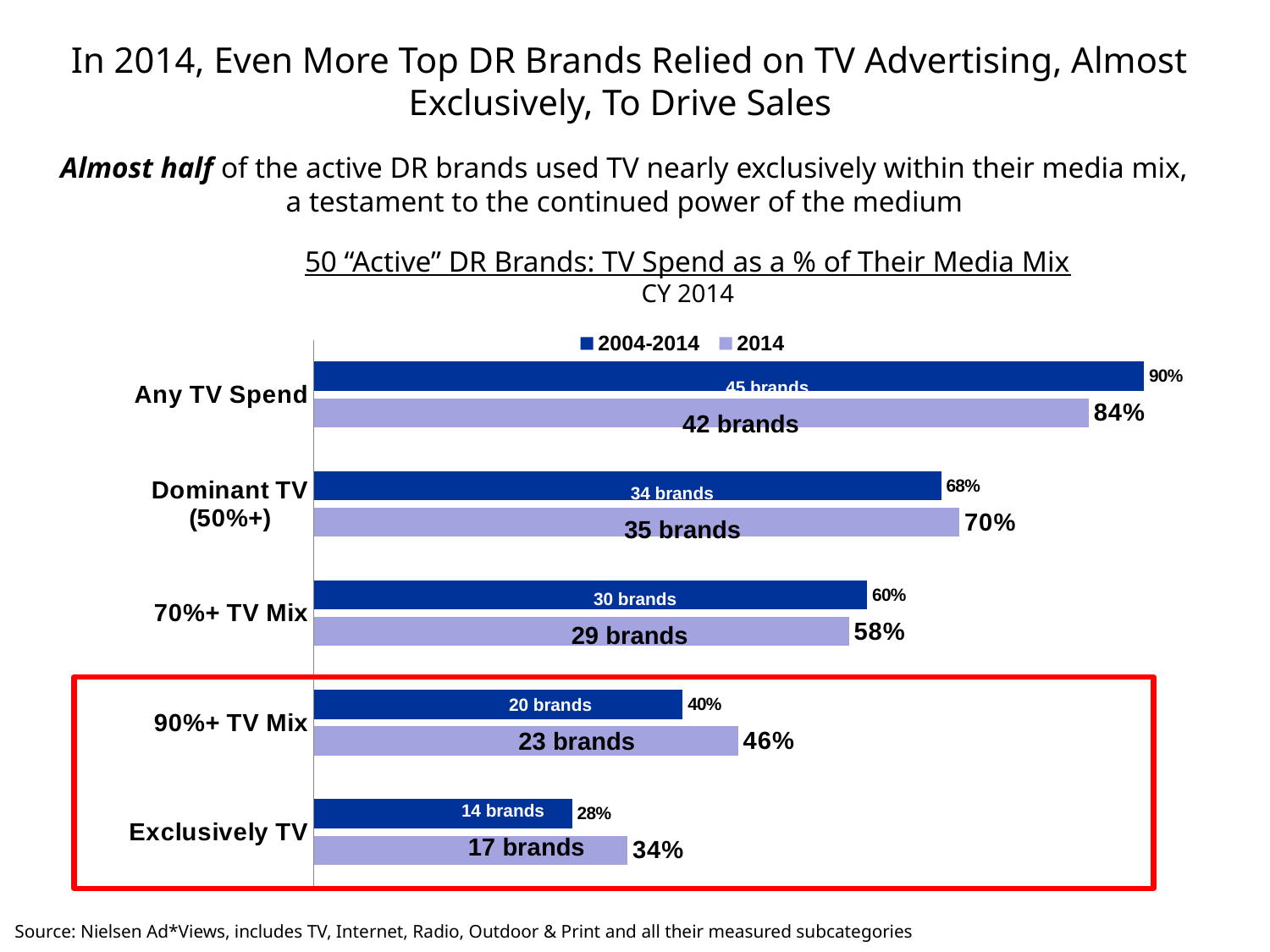
What is the 2014 value for Any TV Spend? 84% What is the 2004-2014 value for Exclusively TV? 28% How many series does the legend list? 2 What is the difference between the 2014 and 2004-2014 values for 90%+ TV Mix? 6% Which category has the lowest 2004-2014 value? Exclusively TV For 70%+ TV Mix, which series has the larger value, 2004-2014 or 2014? 2004-2014 Which category has the highest 2014 value? Any TV Spend How many brands does the 2014 bar for 90%+ TV Mix represent? 23 brands How many categories are shown on the chart? 5 What kind of chart is shown on the slide? Bar chart What is the 2004-2014 value for Dominant TV (50%+)? 68% What is the title of the chart? 50 "Active" DR Brands: TV Spend as a % of Their Media Mix